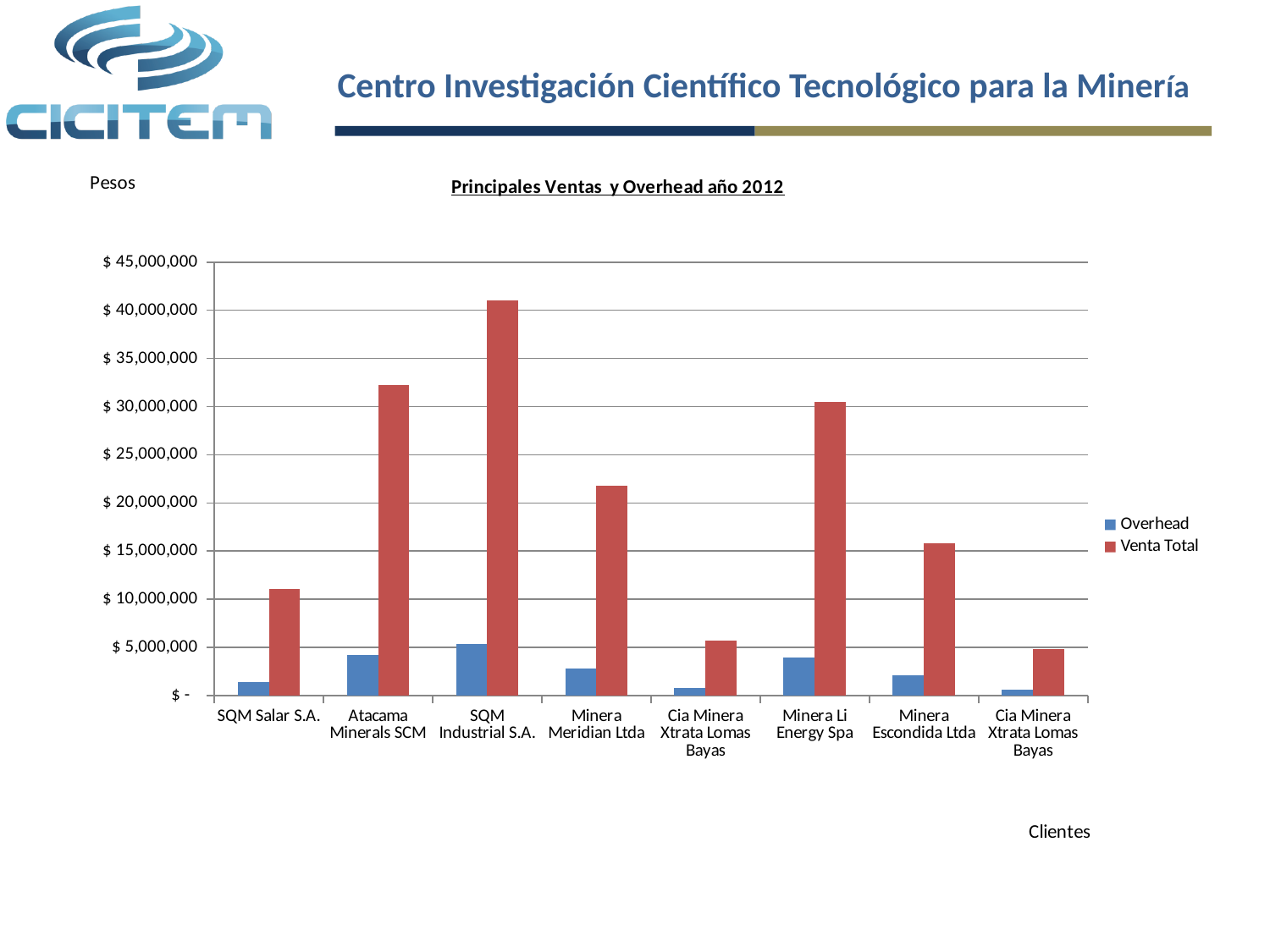
Is the Venta Total for Minera Meridian Ltda greater or less than $ 20,000,000? greater How many series does the legend list? 2 Is the Venta Total for Atacama Minerals SCM greater or less than $ 30,000,000? greater Which client has the highest Venta Total? SQM Industrial S.A. What kind of chart is shown on the slide? bar chart Which client has the highest Overhead? SQM Industrial S.A. How many client categories are shown on the x axis? 8 Is the Overhead for Atacama Minerals SCM greater or less than $ 5,000,000? less Which is larger, the Venta Total for Minera Meridian Ltda or for Minera Escondida Ltda? Minera Meridian Ltda What is the title of the chart? Principales Ventas y Overhead año 2012